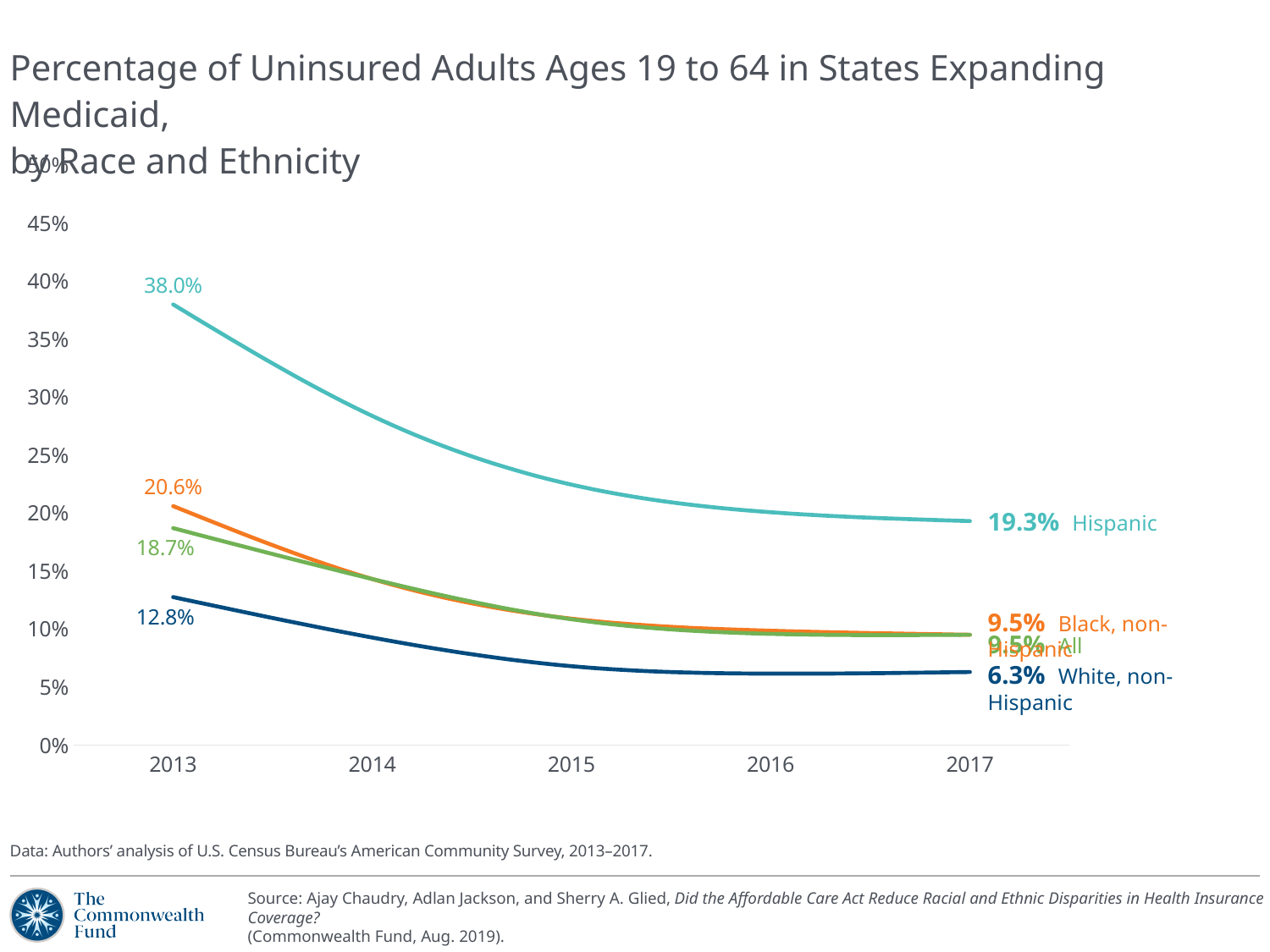
Does the uninsured rate for Hispanic adults rise or fall from 2013 to 2017? Fall Which group had the highest uninsured rate in 2013? Hispanic What was the percentage of uninsured Hispanic adults in 2013? 38.0% How many years are shown on the x axis? 5 What type of chart is shown on the slide? Line chart What was the percentage of uninsured Hispanic adults in 2017? 19.3% Is the uninsured rate for Hispanic adults in 2015 greater or less than 25%? less Which group had the lowest uninsured rate in 2017? White, non-Hispanic What was the percentage of uninsured White, non-Hispanic adults in 2013? 12.8% What was the percentage of uninsured White, non-Hispanic adults in 2017? 6.3% What was the percentage of uninsured Black, non-Hispanic adults in 2013? 20.6% By how many percentage points did the uninsured rate for Hispanic adults fall from 2013 to 2017? 18.7 percentage points